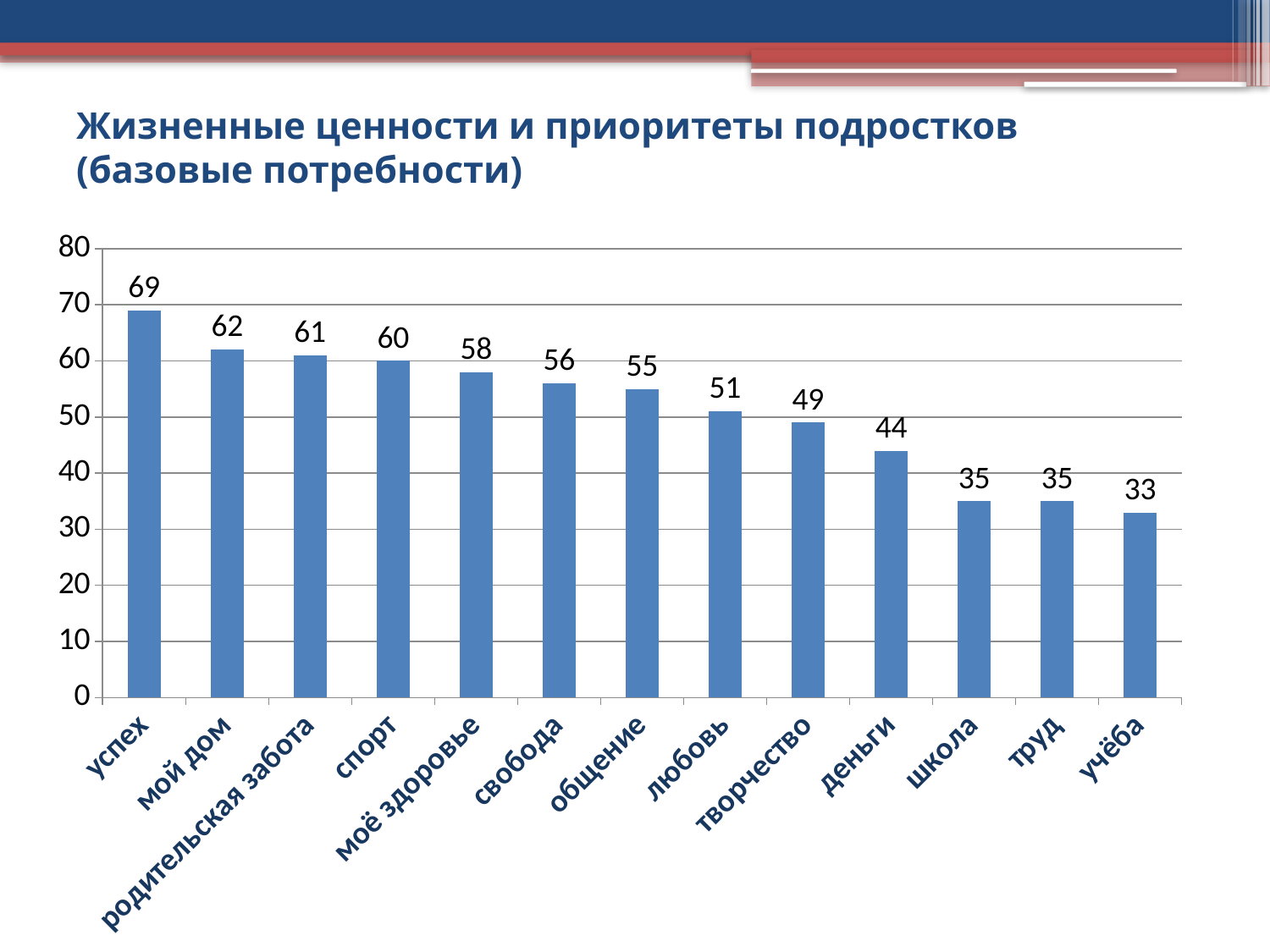
Which category has the lowest value? учёба How many categories are shown on the x axis? 13 What is the value for успех? 69 What is the title of the slide? Жизненные ценности и приоритеты подростков (базовые потребности) Which is larger, the value for спорт or the value for общение? спорт What is the value for деньги? 44 What kind of chart is shown on the slide? bar chart What is the difference between the values for успех and учёба? 36 What is the value for творчество? 49 What is the difference between the values for мой дом and любовь? 11 Do the values rise or fall from left to right along the x axis? fall Which category has the highest value? успех